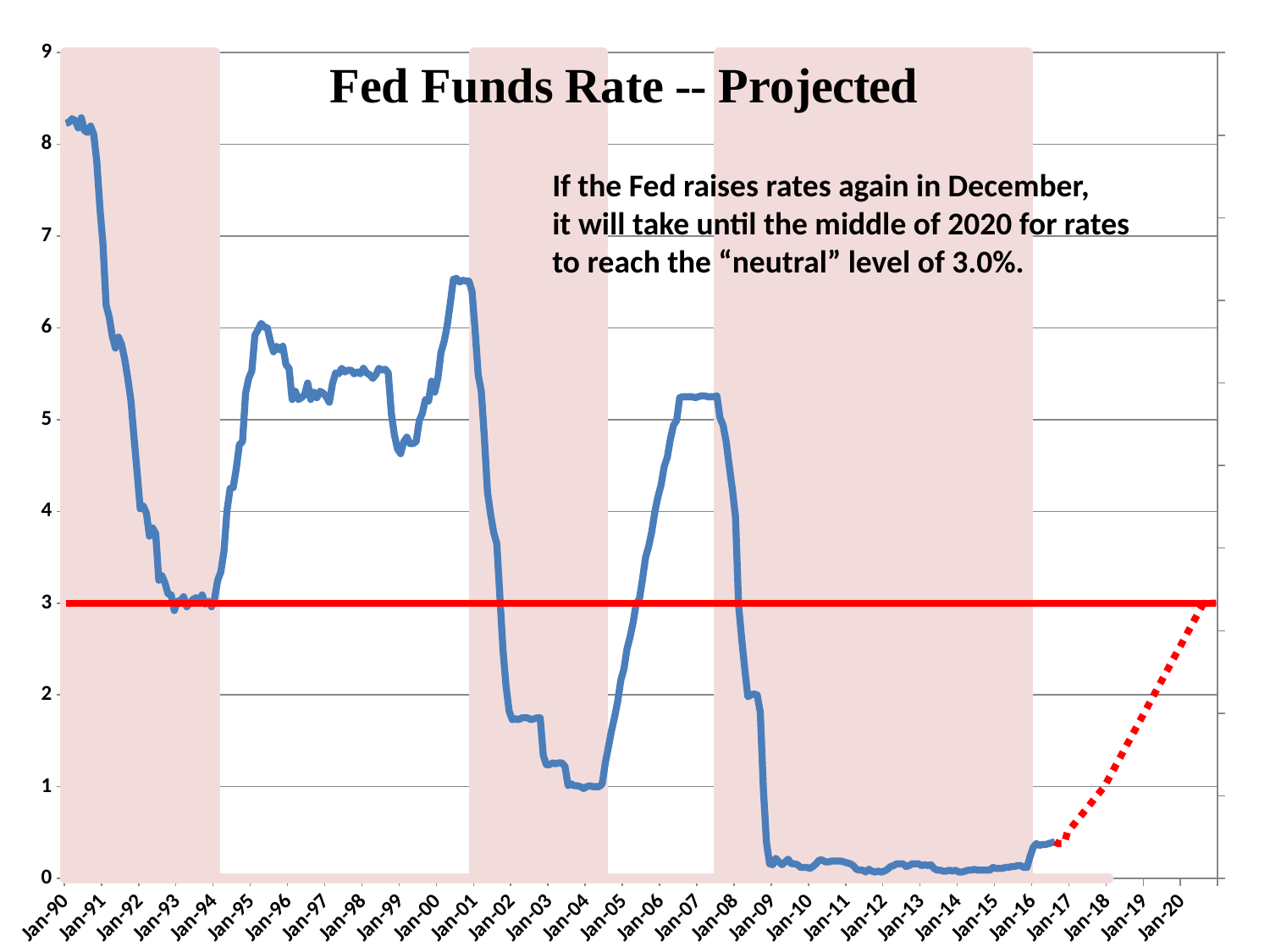
What is the title of the chart? Fed Funds Rate -- Projected Is the value for Jan-07 greater or less than 5? greater Is the value for Jan-90 greater or less than 7? greater Does the Fed Funds Rate rise or fall between Jan-04 and Jan-07? rise Is the value for Jan-10 greater or less than 1? less Which is larger, the value for Jan-90 or the value for Jan-01? Jan-90 At what level on the y axis is the solid red horizontal line drawn? 3 What kind of chart is shown on the slide? line chart Does the Fed Funds Rate rise or fall between Jan-01 and Jan-04? fall What is the highest value shown on the y axis? 9